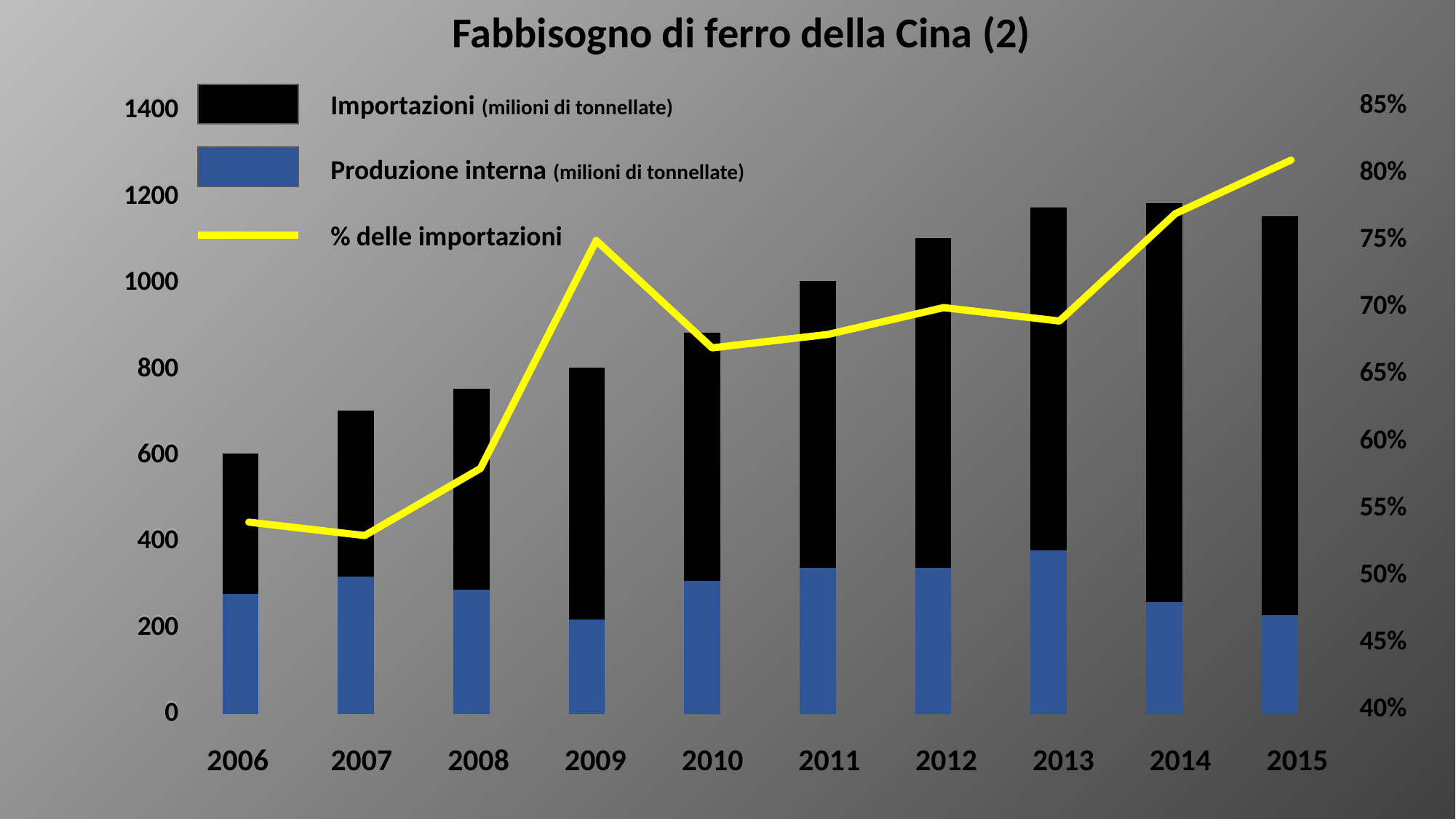
Which year has the lowest total stacked bar (Importazioni plus Produzione interna)? 2006 Is the Produzione interna value for 2009 greater or less than 400? less Is the '% delle importazioni' value for 2010 greater or less than 70%? less What is the title of the chart? Fabbisogno di ferro della Cina (2) What kind of chart is shown on the slide? bar chart with a line How many years are shown on the x axis? 10 Does the '% delle importazioni' line rise or fall overall from 2010 to 2015? rise In which year is the '% delle importazioni' line at its highest? 2015 Which colour is used for the '% delle importazioni' line? yellow Is the total stacked bar for 2015 greater or less than 1000? greater Which year has the larger total stacked bar, 2008 or 2012? 2012 How many series does the legend list? 3